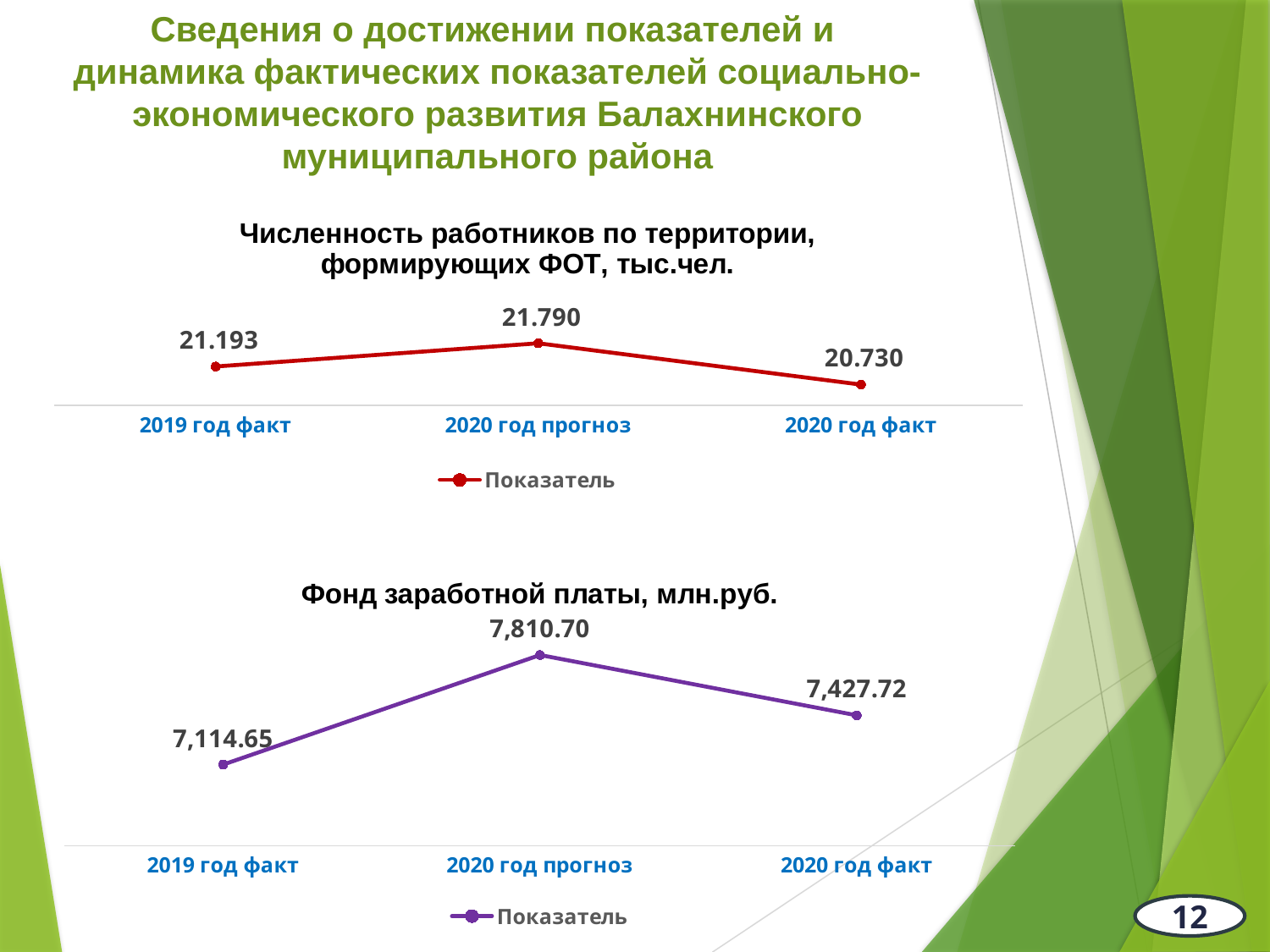
In the chart 'Численность работников по территории, формирующих ФОТ, тыс.чел.', what is the value for 2020 год прогноз? 21.790 What type of chart is the bottom chart 'Фонд заработной платы, млн.руб.'? Line chart In the chart 'Численность работников по территории, формирующих ФОТ, тыс.чел.', which category has the lowest value? 2020 год факт In the chart 'Фонд заработной платы, млн.руб.', what is the value for 2020 год факт? 7,427.72 In the chart 'Фонд заработной платы, млн.руб.', what is the difference between the 2020 год прогноз and 2019 год факт values? 696.05 In the chart 'Фонд заработной платы, млн.руб.', what is the value for 2019 год факт? 7,114.65 In the chart 'Фонд заработной платы, млн.руб.', how many data points are plotted? 3 In the chart 'Фонд заработной платы, млн.руб.', which category has the highest value? 2020 год прогноз How many series does the legend of the top chart 'Численность работников по территории, формирующих ФОТ, тыс.чел.' list? 1 In the chart 'Численность работников по территории, формирующих ФОТ, тыс.чел.', which is larger: 2019 год факт or 2020 год факт? 2019 год факт In the chart 'Численность работников по территории, формирующих ФОТ, тыс.чел.', what is the difference between the 2020 год прогноз and 2020 год факт values? 1.060 In the chart 'Численность работников по территории, формирующих ФОТ, тыс.чел.', what is the value for 2020 год факт? 20.730